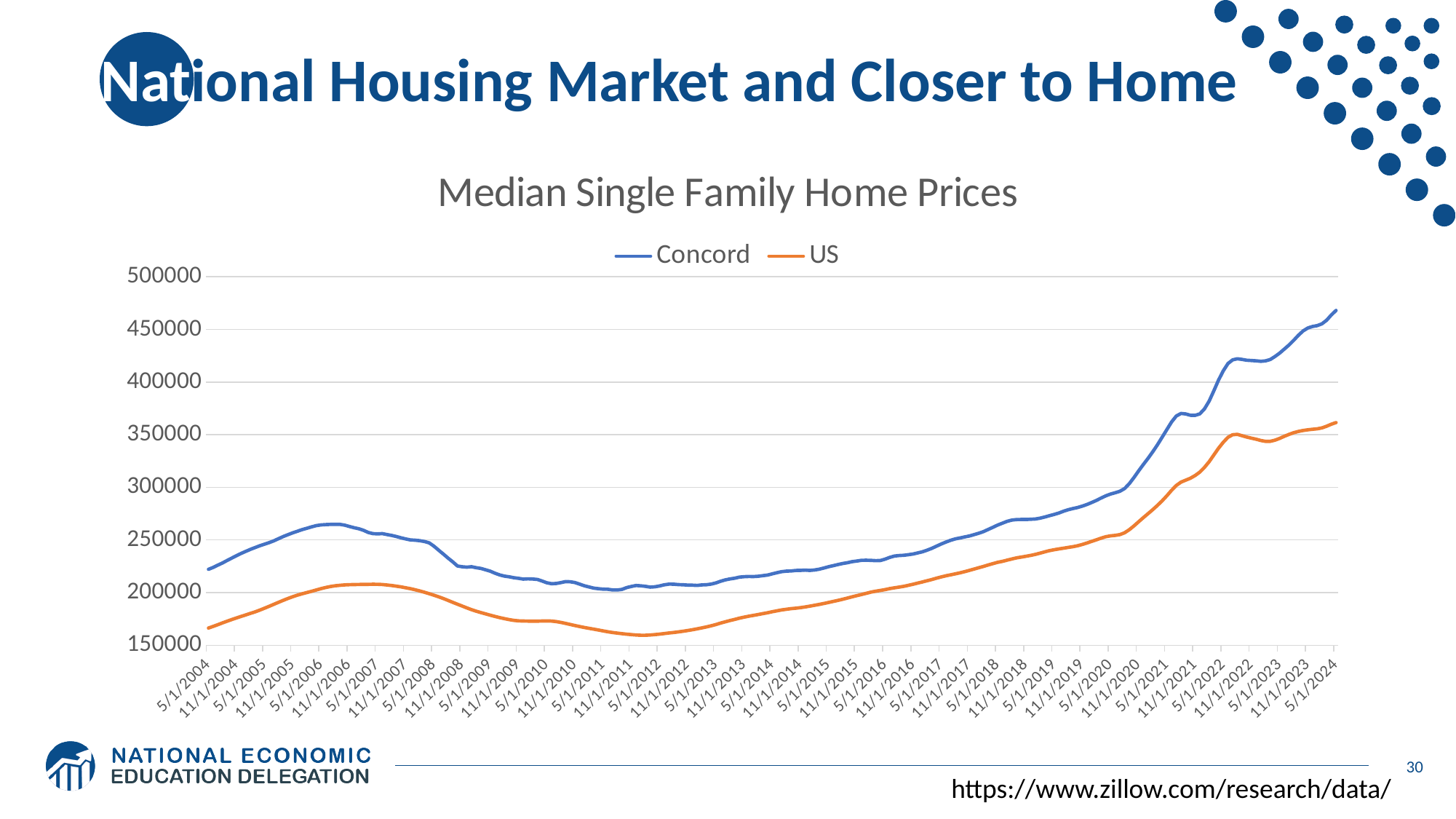
What are the two series named in the legend? Concord and US Which series has the lowest value shown on the chart? US How many series does the legend list? 2 Is the Concord value at 11/1/2006 greater or less than 300000? less Is the US value at 5/1/2012 greater or less than 200000? less Is the US value at 5/1/2004 greater or less than 200000? less Do the Concord values rise or fall between 11/1/2011 and 5/1/2024? rise Which series reaches the highest value on the chart? Concord What is the title of the chart? Median Single Family Home Prices What kind of chart is shown on the slide? line chart At 5/1/2024, which series has the higher value, Concord or US? Concord